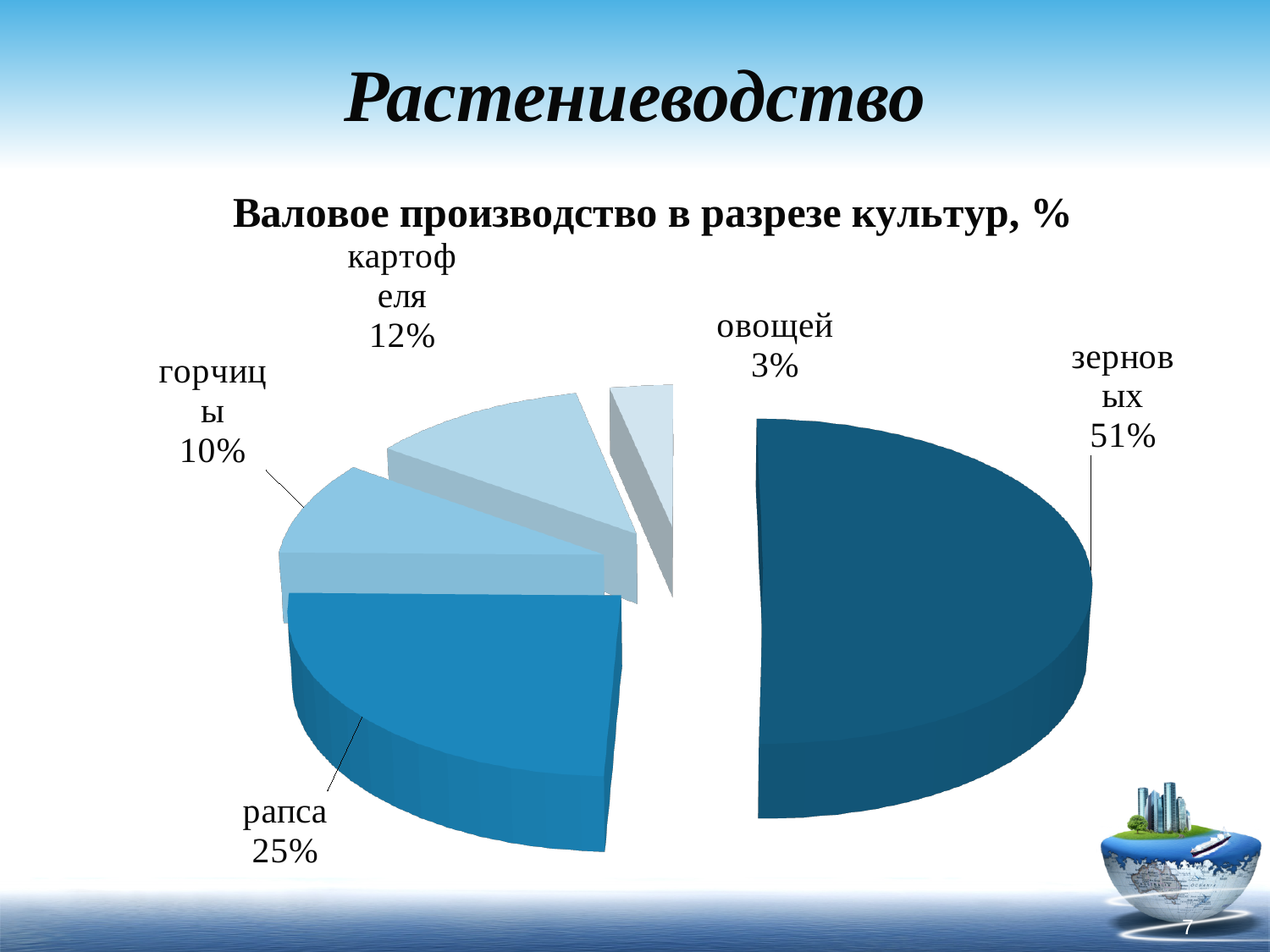
How many percentage points larger is the share of зерновых than the share of рапса? 26 What percentage is shown for овощей? 3% What type of chart is shown on the slide? pie chart What percentage is shown for рапса? 25% What percentage is shown for горчицы? 10% What is the title of the chart? Валовое производство в разрезе культур, % Which crop has the smallest share of gross production? овощей How many crop categories are shown in the pie chart? 5 What percentage is shown for картофеля? 12% Which has a larger share, картофеля or горчицы? картофеля Which crop has the largest share of gross production? зерновых What share of gross production does зерновых account for? 51%